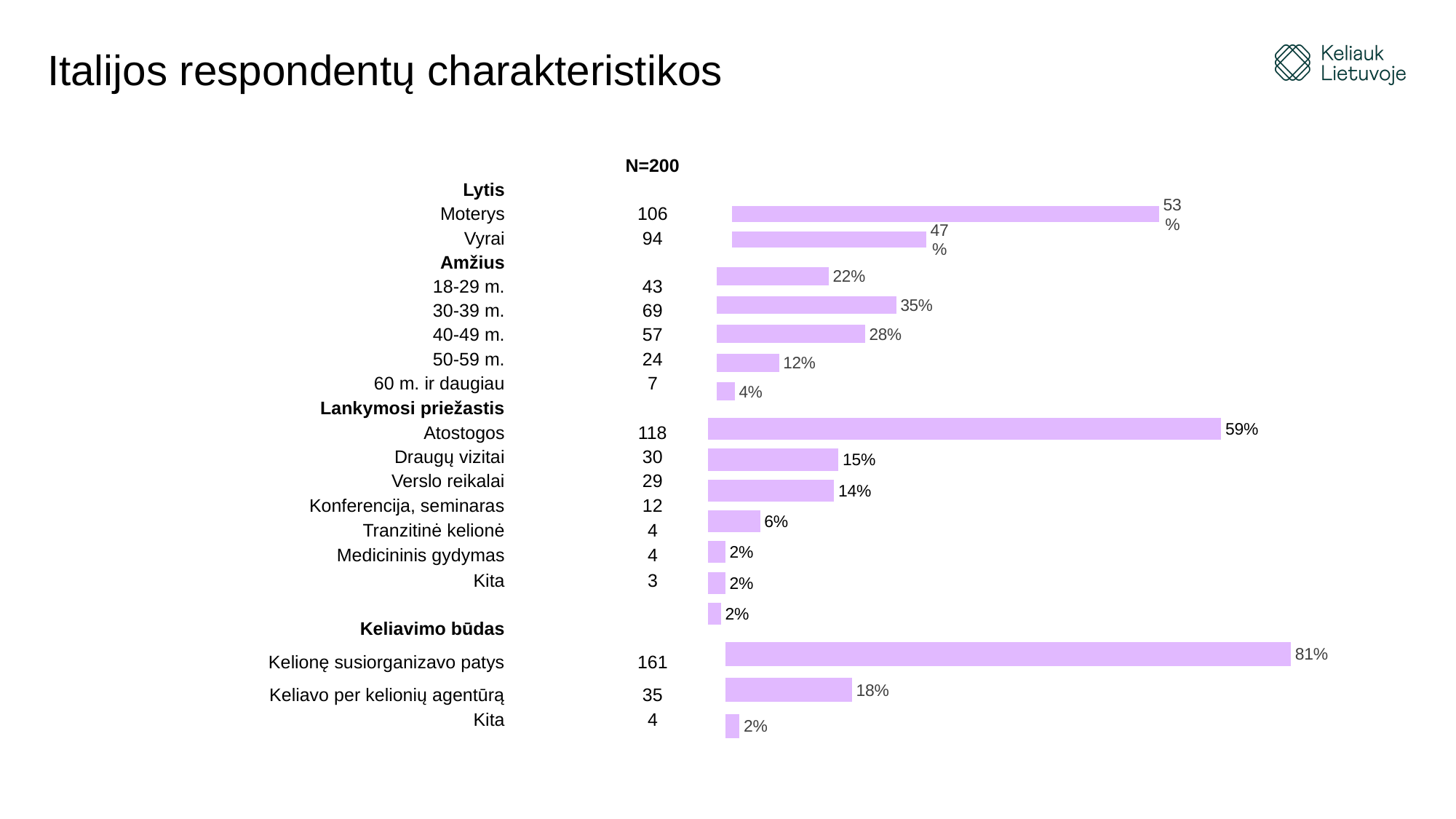
What type of chart is shown on the slide? bar chart What is the total number of respondents (N) shown on the slide? N=200 What percentage of respondents chose Keliavo per kelionių agentūrą? 18% What percentage of respondents gave Atostogos as their reason for visiting? 59% Which age group has the lowest share of respondents? 60 m. ir daugiau What percentage of respondents are in the 30-39 m. age group? 35% What percentage of respondents are Moterys? 53% Which is larger, the share for Draugų vizitai or for Verslo reikalai? Draugų vizitai What is the difference in percentage points between Moterys and Vyrai? 6 Which age group has the highest share of respondents? 30-39 m. What is the title of the slide? Italijos respondentų charakteristikos How many categories are listed under Lankymosi priežastis? 7